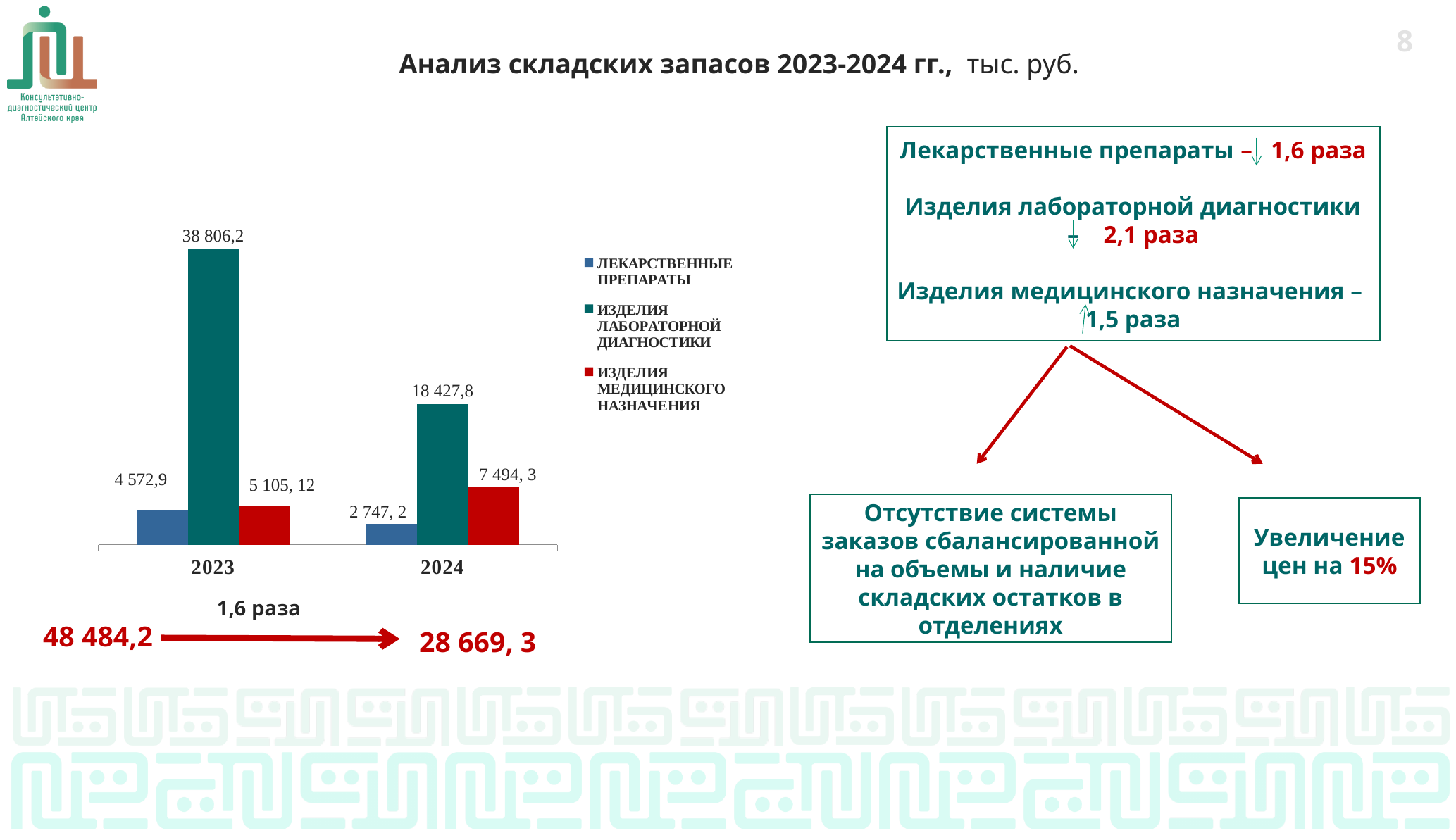
What is the value for ИЗДЕЛИЯ МЕДИЦИНСКОГО НАЗНАЧЕНИЯ in 2024? 7 494, 3 What is the value for ИЗДЕЛИЯ ЛАБОРАТОРНОЙ ДИАГНОСТИКИ in 2024? 18 427,8 By how much did the value for ИЗДЕЛИЯ ЛАБОРАТОРНОЙ ДИАГНОСТИКИ decrease from 2023 to 2024? 20 378,4 What kind of chart is shown on the slide? Bar chart Which series and year has the highest bar in the chart? ИЗДЕЛИЯ ЛАБОРАТОРНОЙ ДИАГНОСТИКИ, 2023 How many year categories are shown on the x axis of the chart? 2 How many series does the chart legend list? 3 For ИЗДЕЛИЯ МЕДИЦИНСКОГО НАЗНАЧЕНИЯ, which year has the larger value, 2023 or 2024? 2024 Which series and year has the lowest bar in the chart? ЛЕКАРСТВЕННЫЕ ПРЕПАРАТЫ, 2024 What is the value for ЛЕКАРСТВЕННЫЕ ПРЕПАРАТЫ in 2023? 4 572,9 Does the value for ИЗДЕЛИЯ ЛАБОРАТОРНОЙ ДИАГНОСТИКИ rise or fall from 2023 to 2024? Fall What is the value for ИЗДЕЛИЯ ЛАБОРАТОРНОЙ ДИАГНОСТИКИ in 2023? 38 806,2